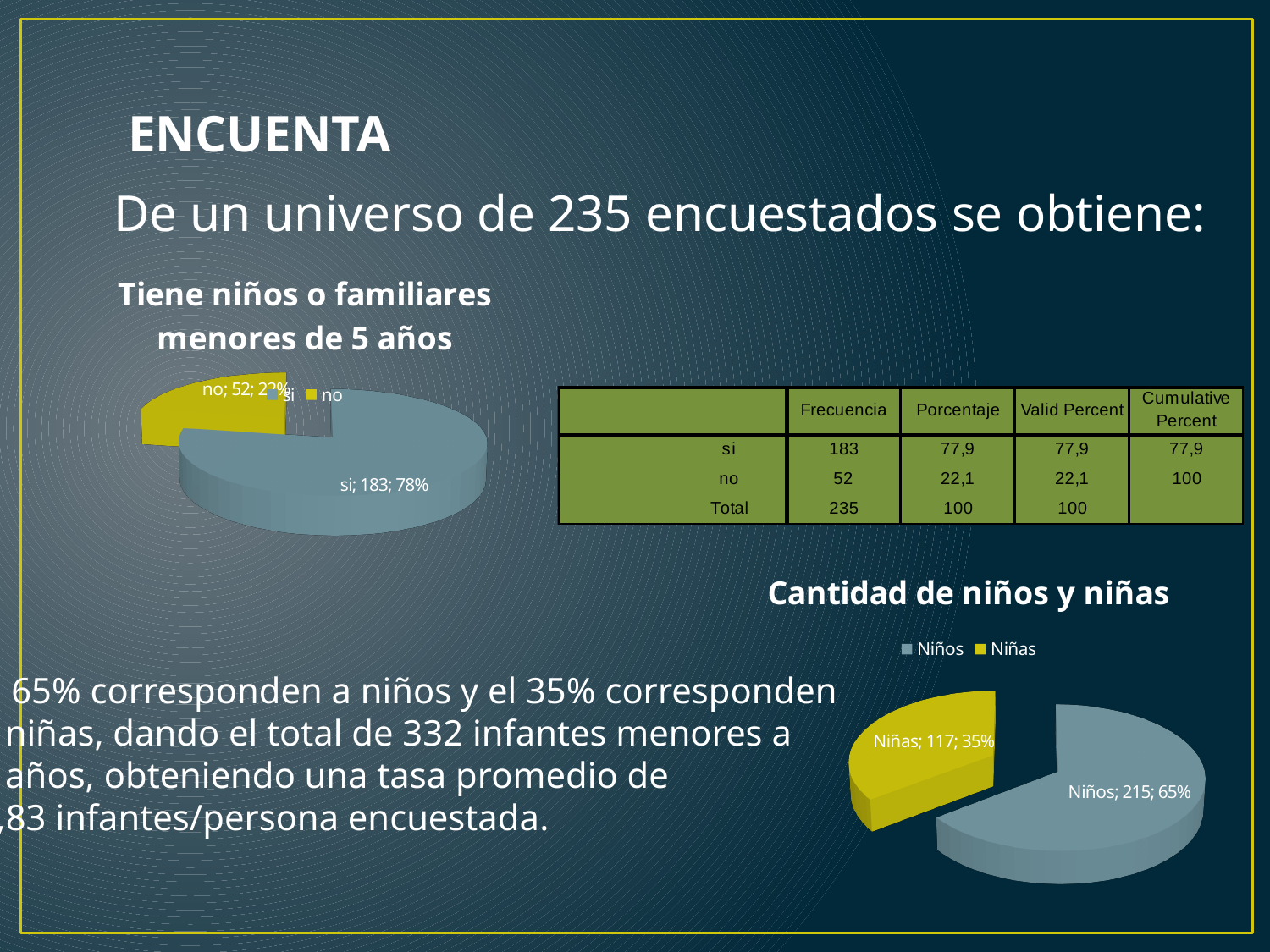
In the 'Cantidad de niños y niñas' chart, what is the difference between the 'Niños' and 'Niñas' values? 98 In the 'Cantidad de niños y niñas' chart, what share of the pie does 'Niñas' represent? 35% In the 'Cantidad de niños y niñas' chart, what is the value for 'Niñas'? 117 In the 'Tiene niños o familiares menores de 5 años' chart, what is the value for 'si'? 183 What kind of chart is 'Tiene niños o familiares menores de 5 años'? Pie chart In the 'Cantidad de niños y niñas' chart, what is the value for 'Niños'? 215 In the 'Tiene niños o familiares menores de 5 años' chart, what is the difference between the 'si' and 'no' values? 131 In the 'Tiene niños o familiares menores de 5 años' chart, what is the value for 'no'? 52 In the 'Tiene niños o familiares menores de 5 años' chart, which category is the largest? si How many entries does the legend of the 'Cantidad de niños y niñas' chart list? 2 In the 'Tiene niños o familiares menores de 5 años' chart, what share of the pie does 'si' represent? 78% In the 'Cantidad de niños y niñas' chart, which category is the smallest? Niñas